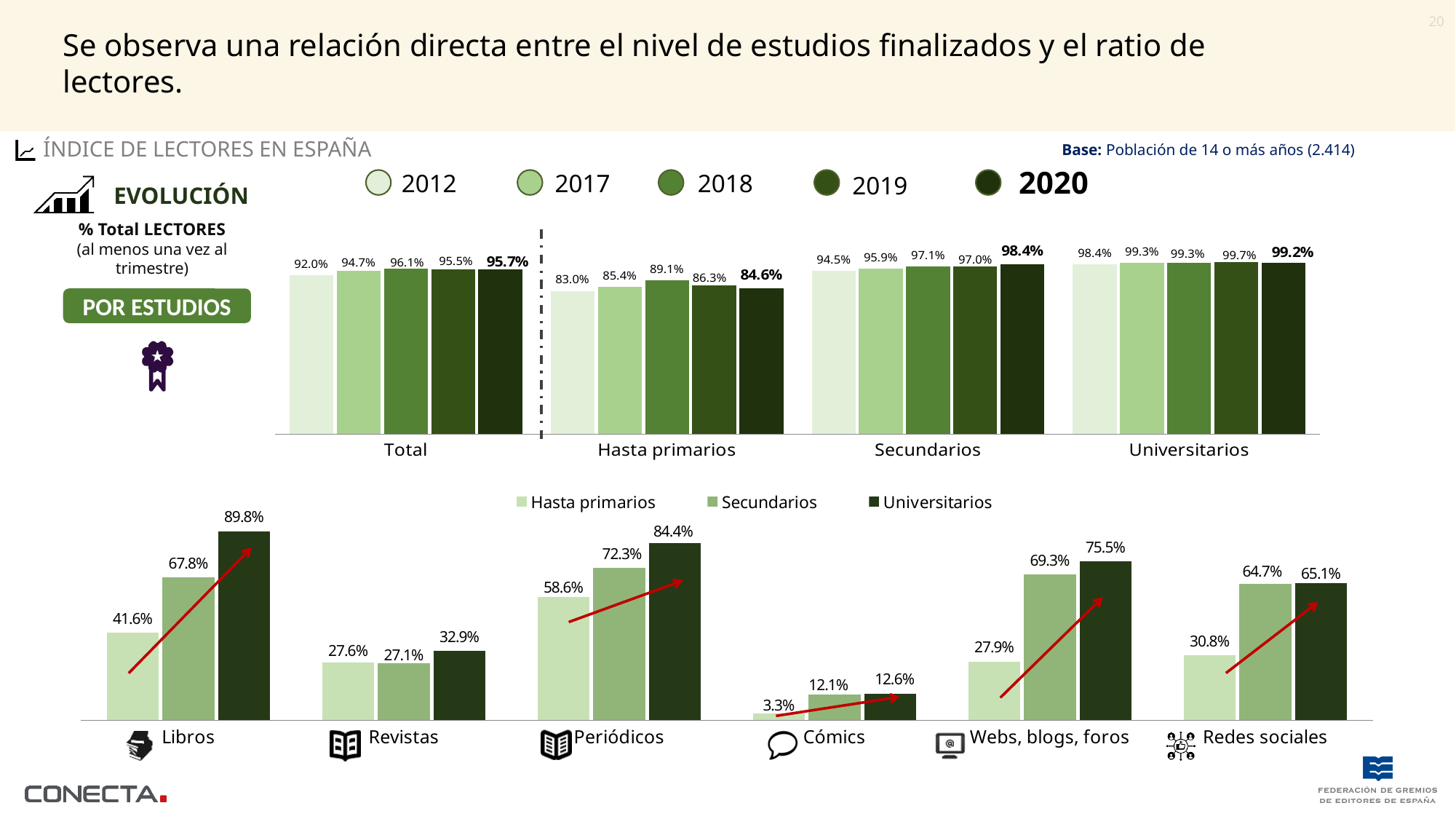
In the top chart, how many years does the legend list? 5 In the bottom chart, which is larger for Redes sociales: Secundarios or Universitarios? Universitarios In the bottom chart, what is the value for Universitarios for Libros? 89.8% In the top chart, what is the difference between the 2020 values for Universitarios and Hasta primarios? 14.6% In the top chart, is the 2018 value for Total larger or smaller than the 2019 value for Total? larger In the top chart, what is the value for Universitarios in 2020? 99.2% What kind of chart is the bottom chart? bar chart In the bottom chart, what is the difference between Universitarios and Hasta primarios for Periódicos? 25.8% In the top chart, what is the value for Hasta primarios in 2012? 83.0% In the bottom chart, which category has the lowest value for Hasta primarios? Cómics In the top chart, which year has the highest value for Secundarios? 2020 In the bottom chart, how many categories are shown on the x axis? 6